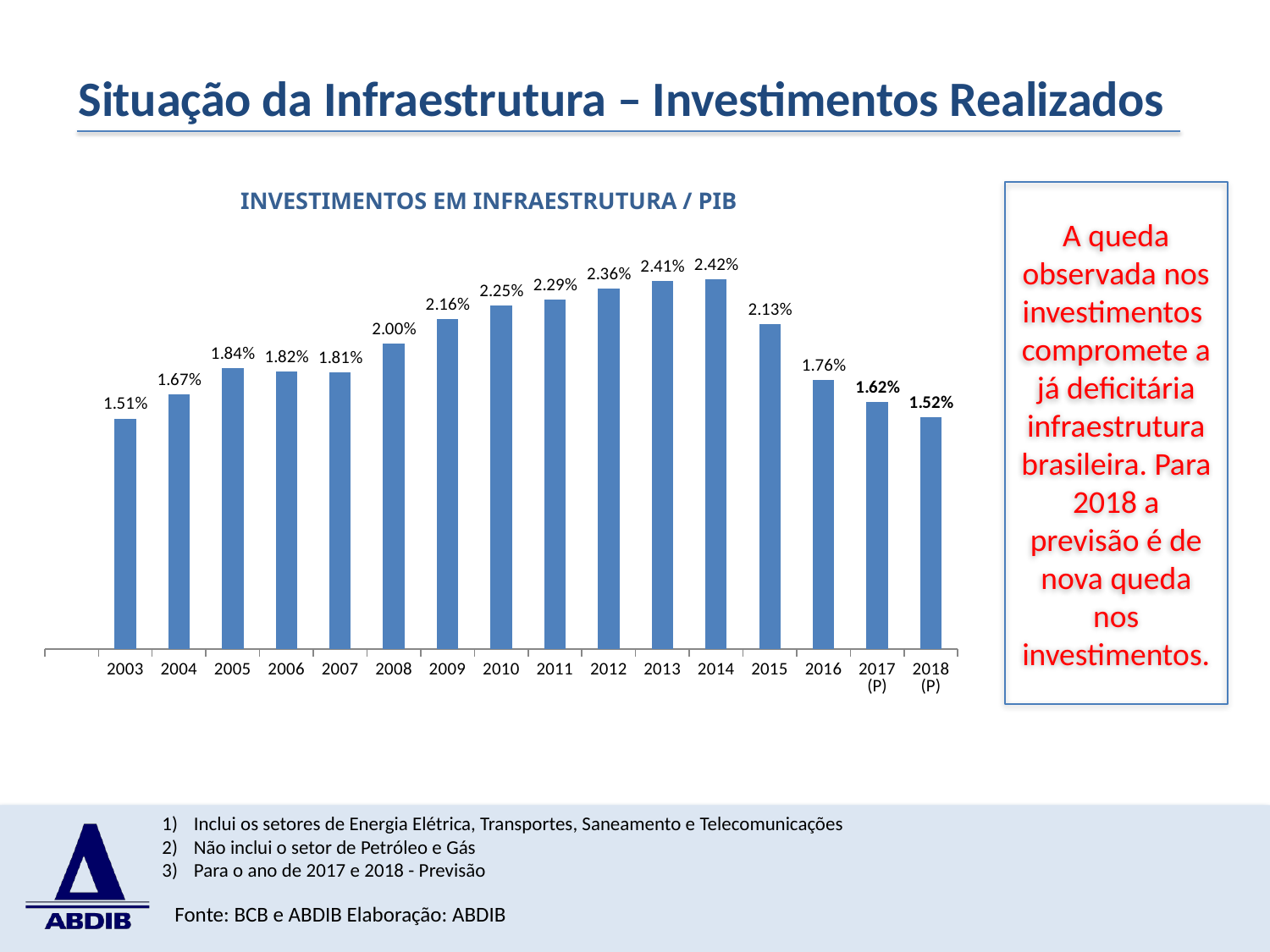
What is the value for 2018 (P)? 1.52% Which is larger, the value for 2008 or the value for 2015? 2015 Do the values rise or fall from 2014 to 2018 (P)? Fall What is the value for 2014? 2.42% What is the difference between the values for 2014 and 2018 (P)? 0.90% What kind of chart is shown? Bar chart Which year has the highest value? 2014 What is the difference between the values for 2016 and 2017 (P)? 0.14% What is the title of the chart? INVESTIMENTOS EM INFRAESTRUTURA / PIB What is the value for 2003? 1.51% Which year has the lowest value? 2003 How many years are shown on the x axis? 16